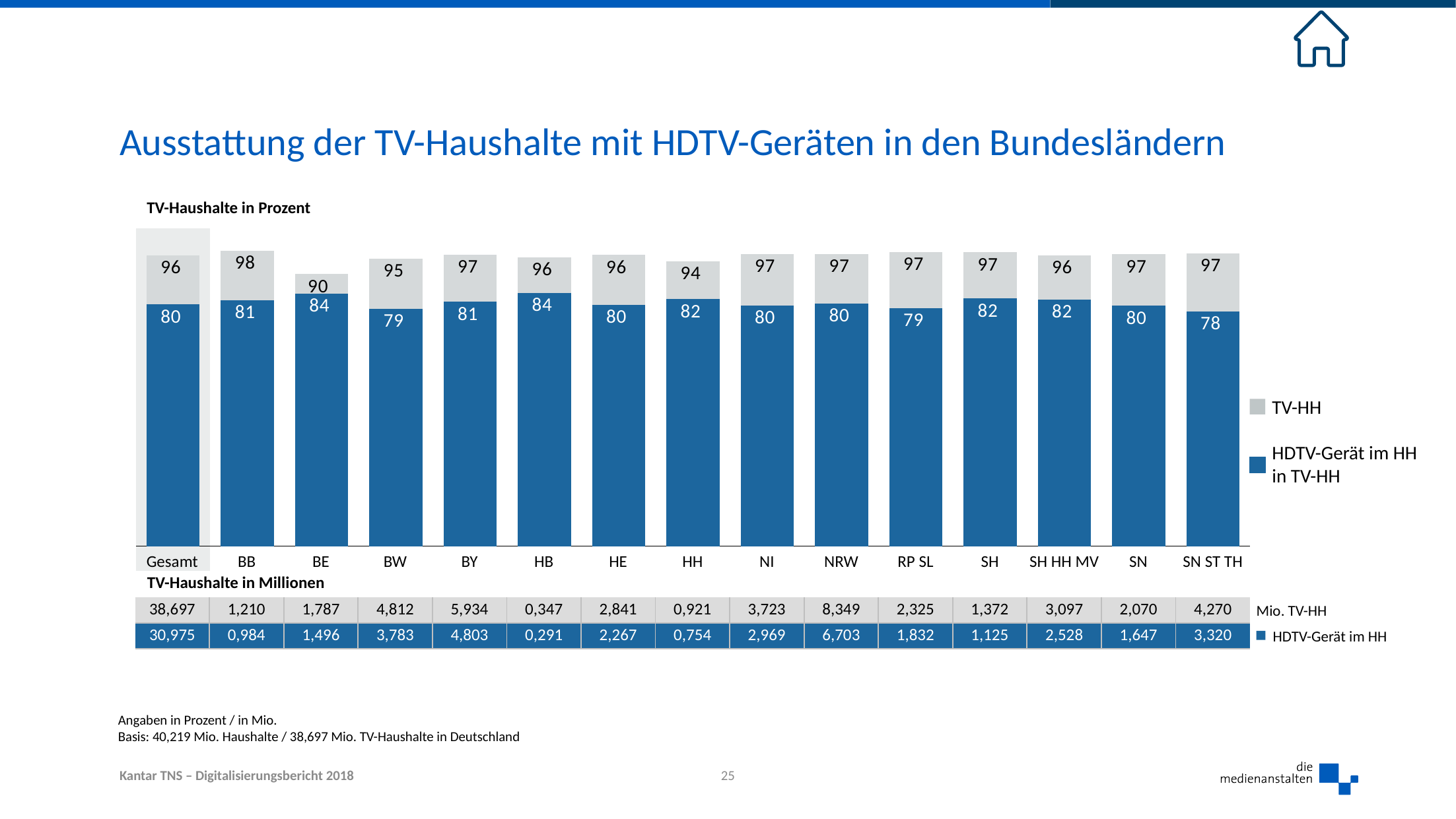
What kind of chart is shown on the slide? bar chart Which category has the lowest HDTV-Gerät im HH in TV-HH value? SN ST TH Which has a higher HDTV-Gerät im HH in TV-HH value, HB or BW? HB How many series does the chart legend list? 2 What is the HDTV-Gerät im HH value in millions for NRW in the table below the chart? 6,703 How many categories are shown on the x axis of the chart? 15 Which category has the highest TV-HH value? BB What is the HDTV-Gerät im HH in TV-HH value for Gesamt? 80 What is the difference between the TV-HH value and the HDTV-Gerät im HH in TV-HH value for BB? 17 Which category has the lowest TV-HH value? BE What is the TV-HH value shown for HH? 94 What percentage of TV households in BE have an HDTV device (HDTV-Gerät im HH in TV-HH)? 84